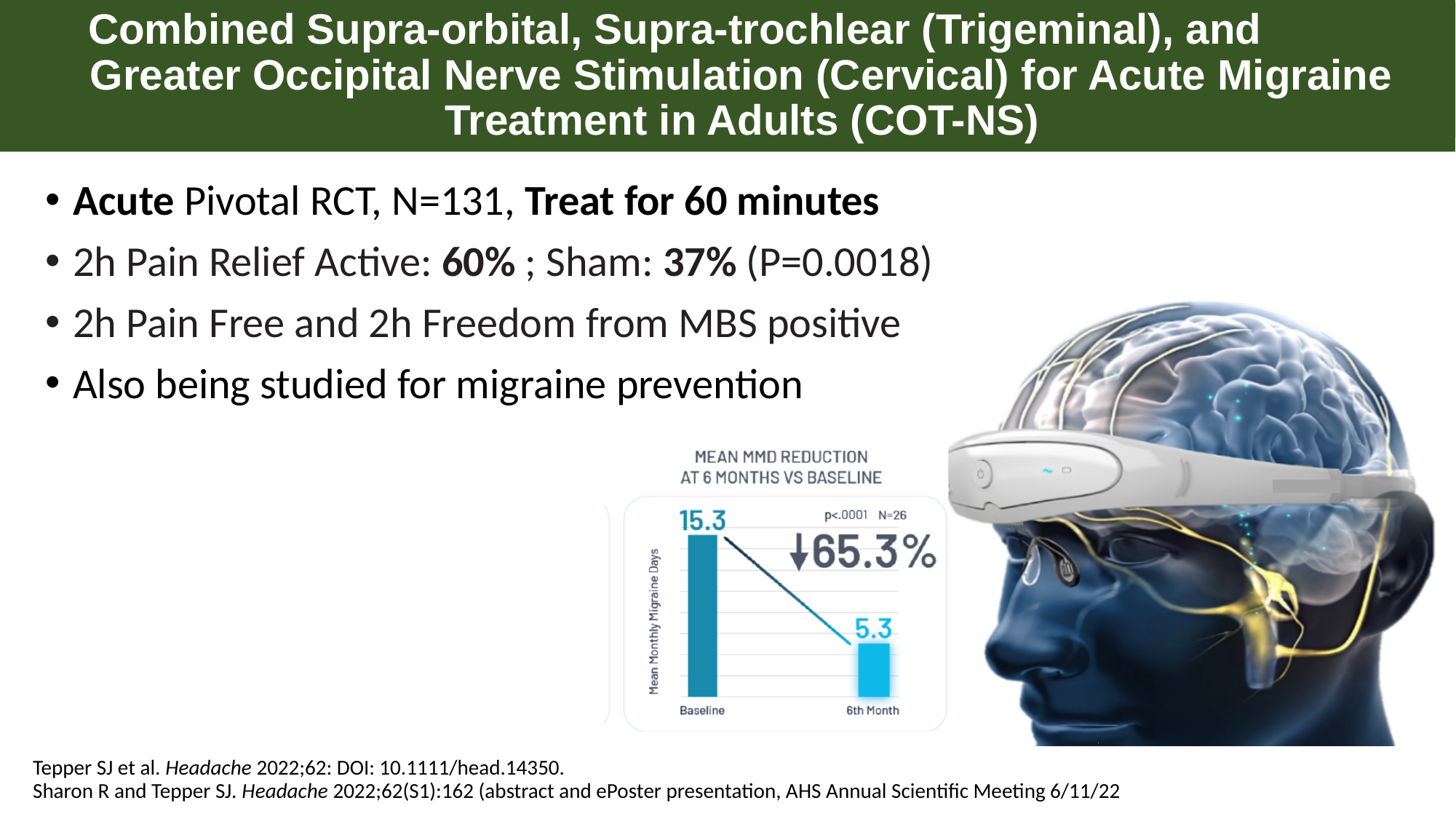
What is the title of the chart? Mean MMD Reduction at 6 Months vs Baseline What is the y-axis label of the chart? Mean Monthly Migraine Days What kind of chart is shown on the slide? bar chart How many bars are shown in the chart? 2 What is the mean monthly migraine days value at 6th Month in the chart? 5.3 Which category has the higher bar in the chart, Baseline or 6th Month? Baseline Which category has the lowest value in the chart? 6th Month What is the mean monthly migraine days value at Baseline in the chart? 15.3 What is the difference between the Baseline and 6th Month values in the chart? 10.0 Do the values in the chart rise or fall from Baseline to 6th Month? fall What percentage reduction is printed on the chart? 65.3%